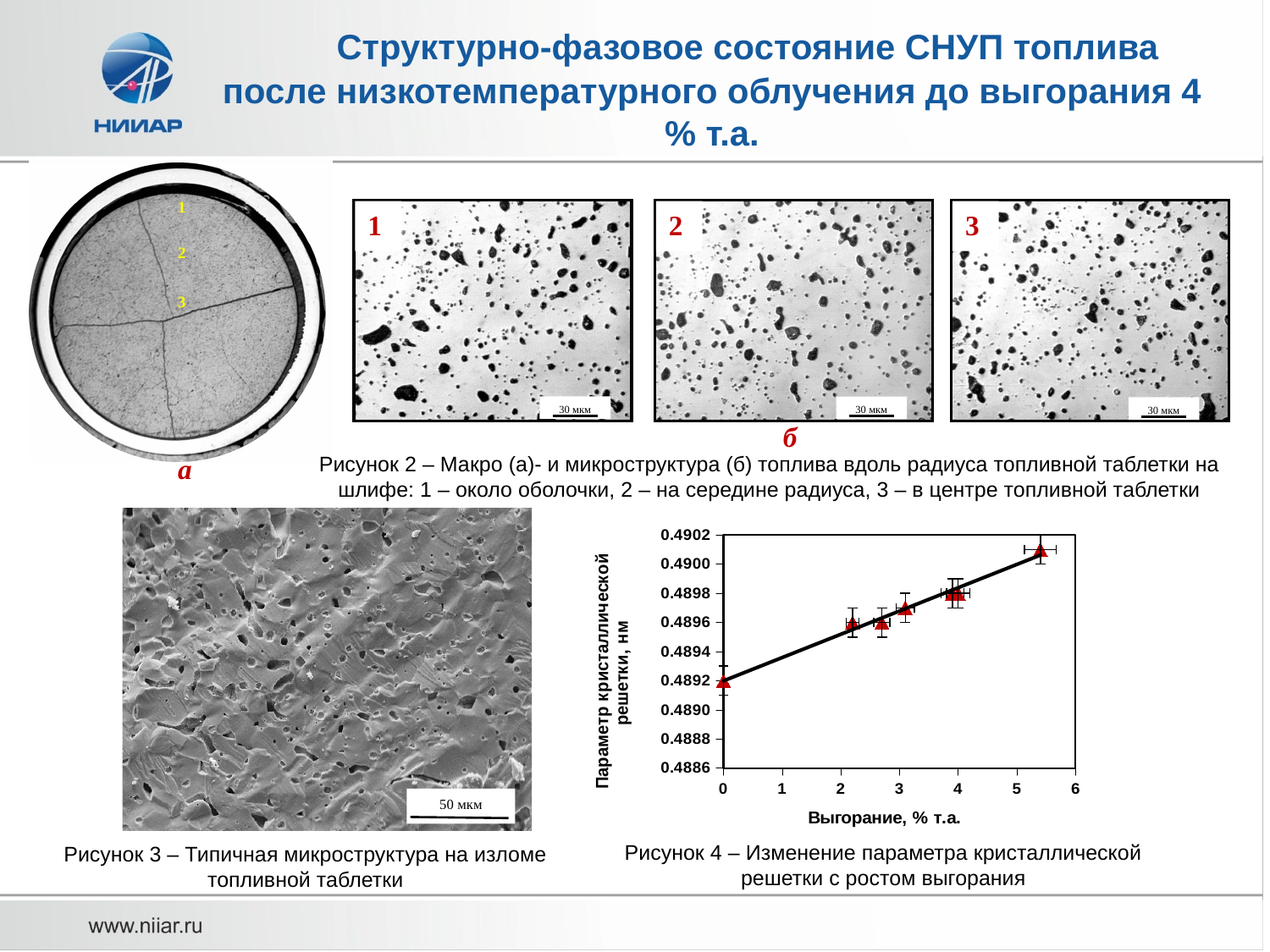
In Рисунок 4, is the lattice parameter at a burnup of 0 % т.а. greater or less than 0.4894? less In Рисунок 4, is the lattice parameter at a burnup of 0 % т.а. greater or less than 0.4890? greater In Рисунок 4, which data point has the lowest lattice parameter? the point at burnup 0 % т.а. What is the y-axis title of the chart in Рисунок 4? Параметр кристаллической решетки, нм What is the x-axis title of the chart in Рисунок 4? Выгорание, % т.а. In Рисунок 4, which has the larger lattice parameter: the point at burnup 0 % т.а. or the point at about 5.4 % т.а.? the point at about 5.4 % т.а. In Рисунок 4, is the lattice parameter at a burnup of about 4 % т.а. greater or less than 0.4896? greater In Рисунок 4, does the lattice parameter rise or fall as burnup (Выгорание) increases? rise What kind of chart is Рисунок 4 (Изменение параметра кристаллической решетки с ростом выгорания)? scatter chart with a trend line In Рисунок 4, which data point has the highest lattice parameter? the point at about 5.4 % т.а.